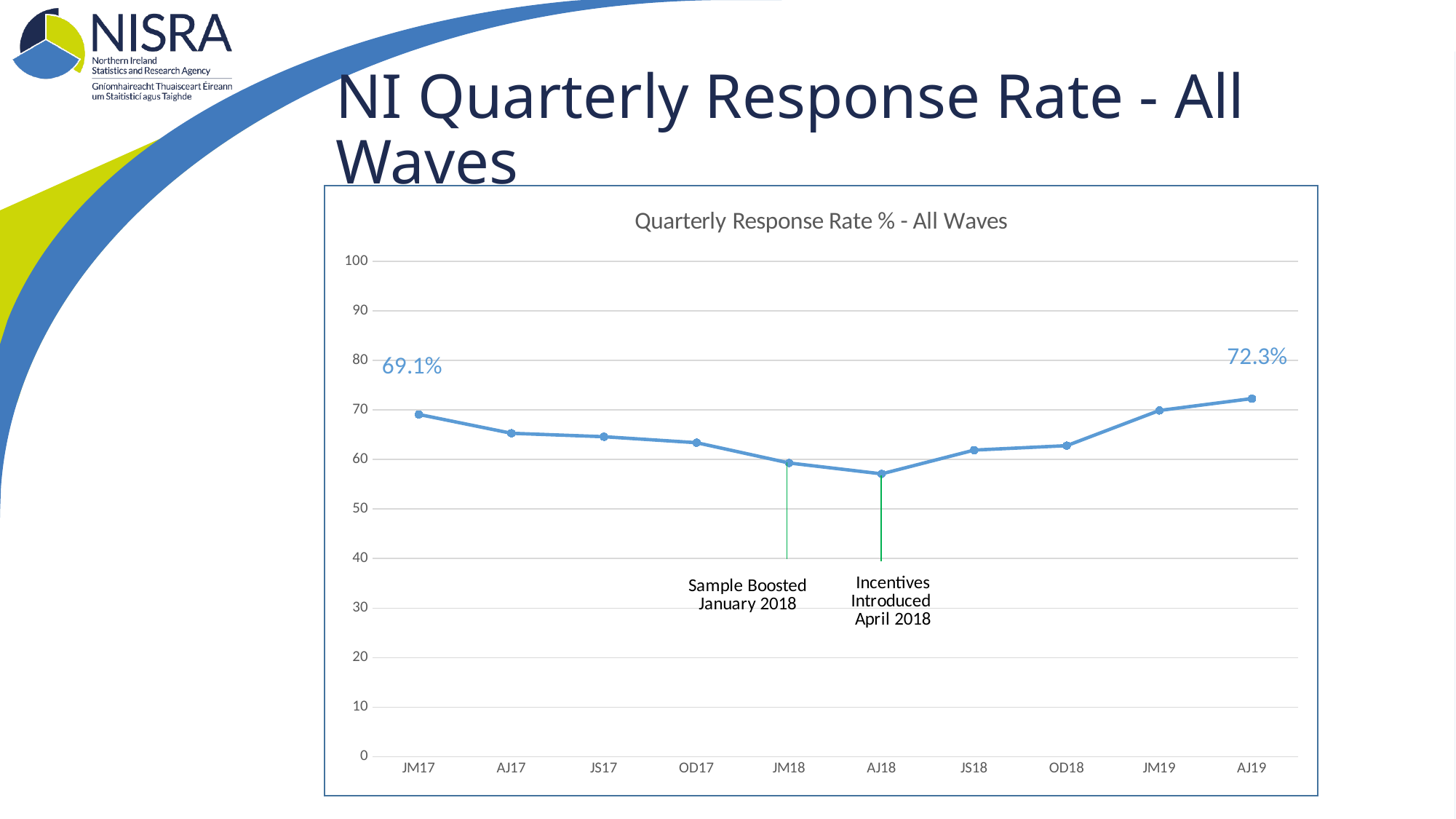
What kind of chart is shown? Line chart What is the response rate for AJ19? 72.3% What is the response rate for JM17? 69.1% Is the value for AJ18 greater or less than 60? less Do the values rise or fall from JM17 to AJ18? fall How many quarters are plotted on the x axis? 10 Which quarter has the highest response rate? AJ19 Which is larger, the value for AJ17 or the value for JM18? AJ17 By how many percentage points does the AJ19 response rate exceed the JM17 response rate? 3.2 Is the value for JM19 greater or less than 60? greater Which quarter has the lowest response rate? AJ18 At which quarter is the 'Incentives Introduced April 2018' annotation placed? AJ18